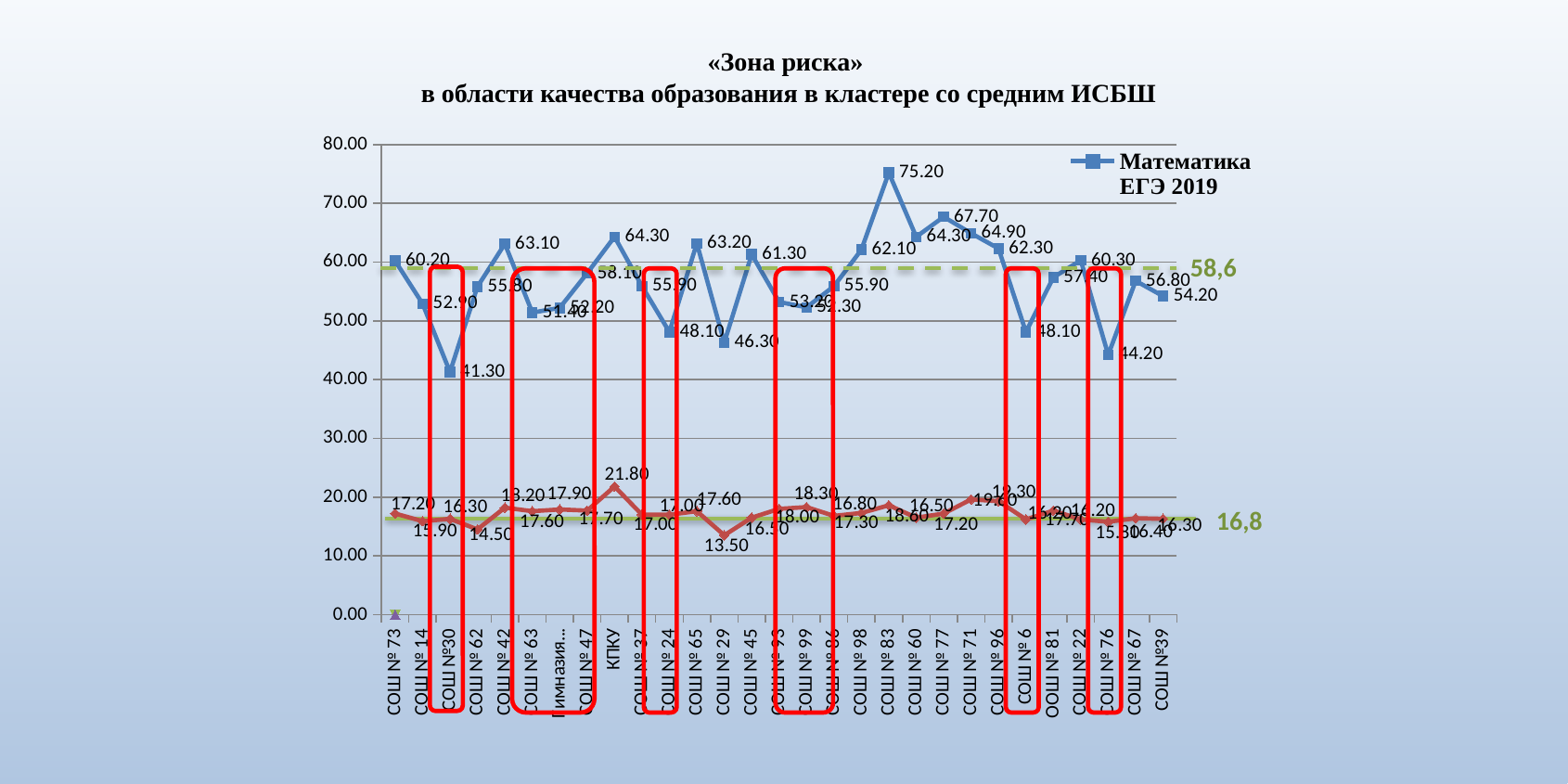
What value is labelled on the upper green dashed reference line? 58,6 Which school has the highest Математика ЕГЭ 2019 value? СОШ № 83 What is the difference between the highest and lowest Математика ЕГЭ 2019 values (СОШ № 83 and СОШ №30)? 33.90 What type of chart is shown on the slide? Line chart Which school has the highest value on the red line? КПКУ Is the Математика ЕГЭ 2019 value for СОШ № 83 greater or less than 70? greater Which school has the lowest Математика ЕГЭ 2019 value? СОШ №30 What is the Математика ЕГЭ 2019 value for СОШ № 76? 44.20 What is the Математика ЕГЭ 2019 value for СОШ №30? 41.30 What is the Математика ЕГЭ 2019 value for СОШ № 83? 75.20 Which has a higher Математика ЕГЭ 2019 value, СОШ № 42 or СОШ № 62? СОШ № 42 What is the Математика ЕГЭ 2019 value for КПКУ? 64.30